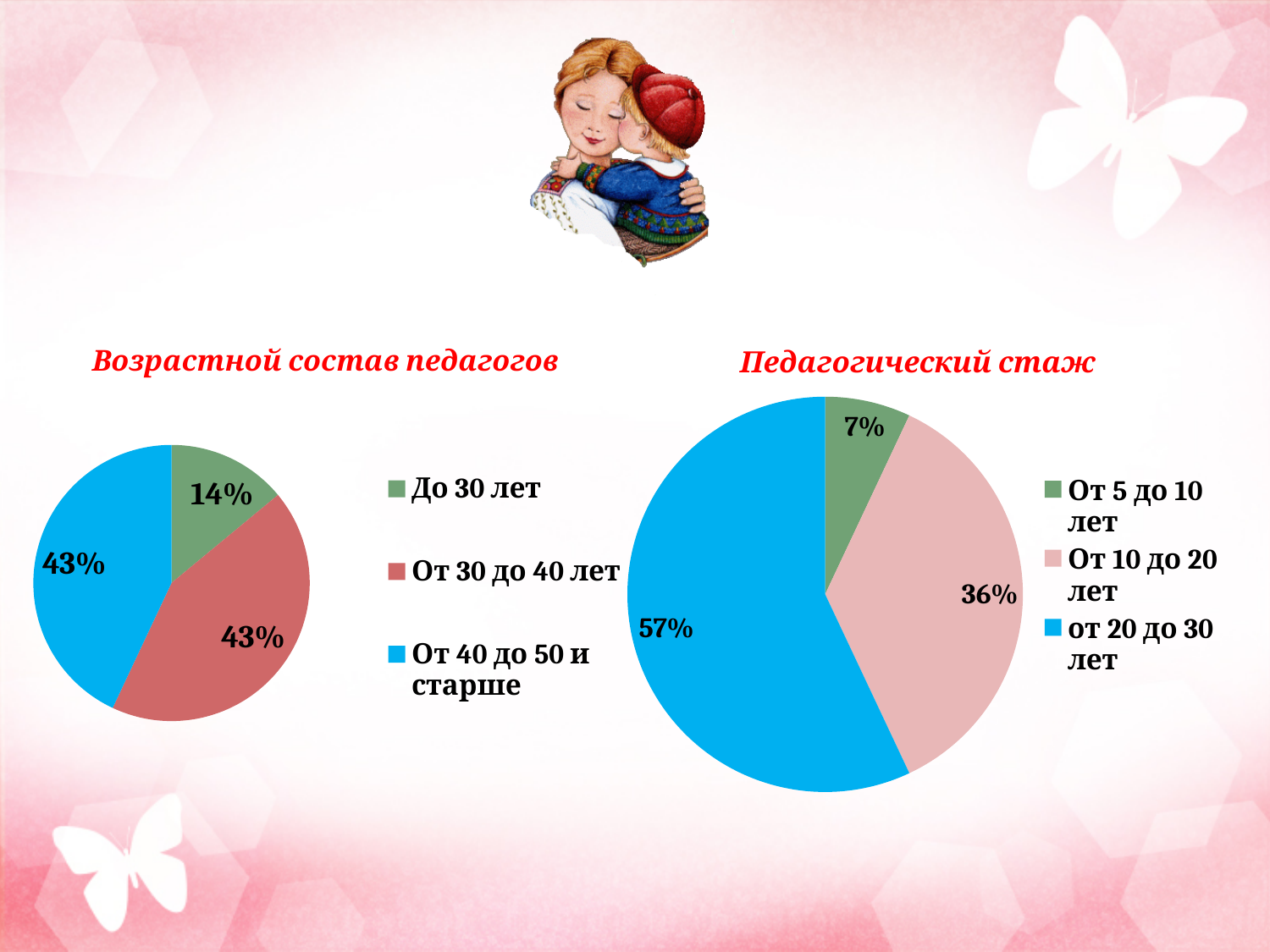
In the chart titled "Педагогический стаж", what colour is the slice for "от 20 до 30 лет"? Blue In the chart titled "Педагогический стаж", which is larger: "От 5 до 10 лет" or "От 10 до 20 лет"? От 10 до 20 лет How many pie charts are shown on the slide? 2 In the chart titled "Педагогический стаж", which category has the largest slice? от 20 до 30 лет In the chart titled "Возрастной состав педагогов", which category has the smallest slice? До 30 лет In the chart titled "Педагогический стаж", which category has the smallest slice? От 5 до 10 лет In the chart titled "Возрастной состав педагогов", what share of the pie is labelled "До 30 лет"? 14% In the chart titled "Возрастной состав педагогов", how many categories does the legend list? 3 In the chart titled "Возрастной состав педагогов", what is the value for "От 30 до 40 лет"? 43% In the chart titled "Педагогический стаж", what is the value for "От 10 до 20 лет"? 36% What kind of chart is the one titled "Возрастной состав педагогов"? Pie chart In the chart titled "Педагогический стаж", what is the difference between the values for "от 20 до 30 лет" and "От 10 до 20 лет"? 21%